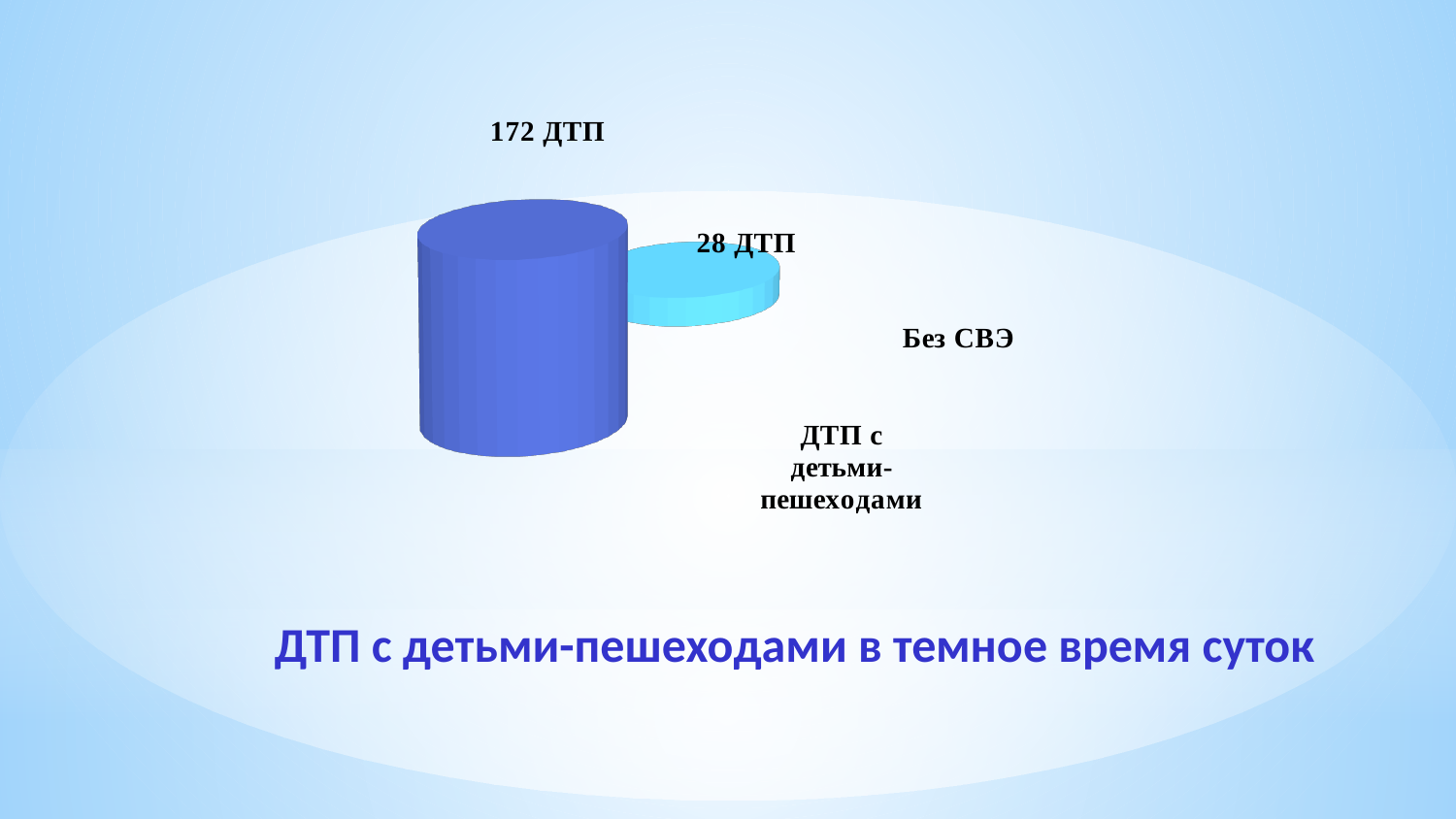
How many bars are plotted in the chart? 2 What colour is the tallest bar in the chart? blue What is the value shown for 'Без СВЭ'? 28 ДТП What is the title of the chart on the slide? ДТП с детьми-пешеходами в темное время суток What value is printed above the tallest bar in the chart? 172 ДТП Which category has the lowest value in the chart? Без СВЭ What type of chart is shown on the slide? bar chart What is the value shown for 'ДТП с детьми-пешеходами'? 172 ДТП What is the difference between the two values shown in the chart, 172 ДТП and 28 ДТП? 144 ДТП Which is larger: the value for 'ДТП с детьми-пешеходами' or the value for 'Без СВЭ'? ДТП с детьми-пешеходами What value is printed above the shortest bar in the chart? 28 ДТП Which category has the highest value in the chart? ДТП с детьми-пешеходами